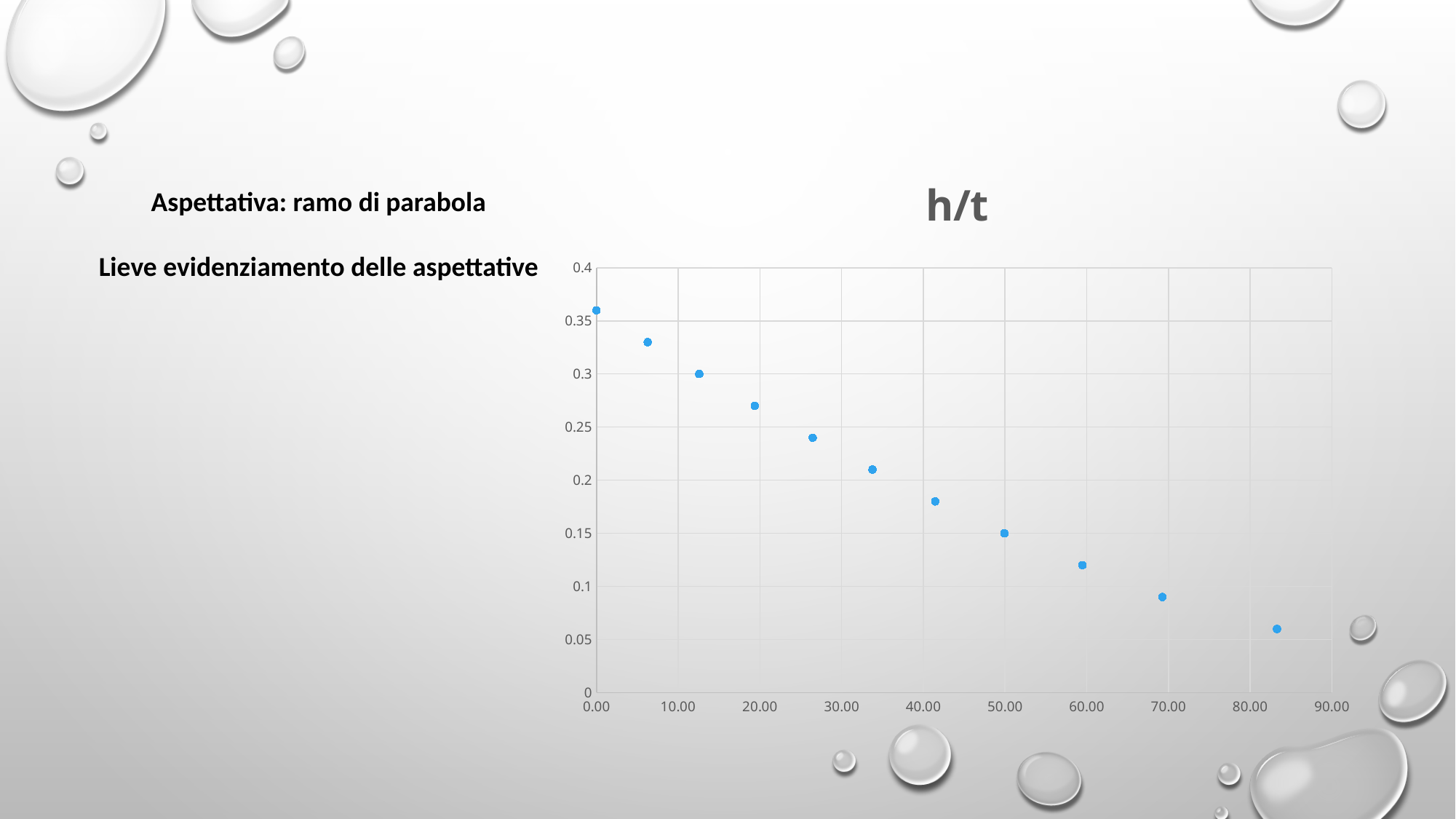
What is the y value of the point at x = 50.00? 0.15 What is the title of the chart? h/t Which has the larger y value, the leftmost point or the rightmost point? the leftmost point Is the y value of the point near x = 40.00 greater or less than 0.2? less What kind of chart is shown on the slide? scatter chart What is the highest value shown on the y axis? 0.4 How many data points are plotted in the chart? 11 Do the plotted values rise or fall as x increases along the x axis? fall Is the y value of the rightmost point greater or less than 0.1? less Is the y value of the point near x = 70.00 greater or less than 0.05? greater What is the y value of the third point from the left? 0.3